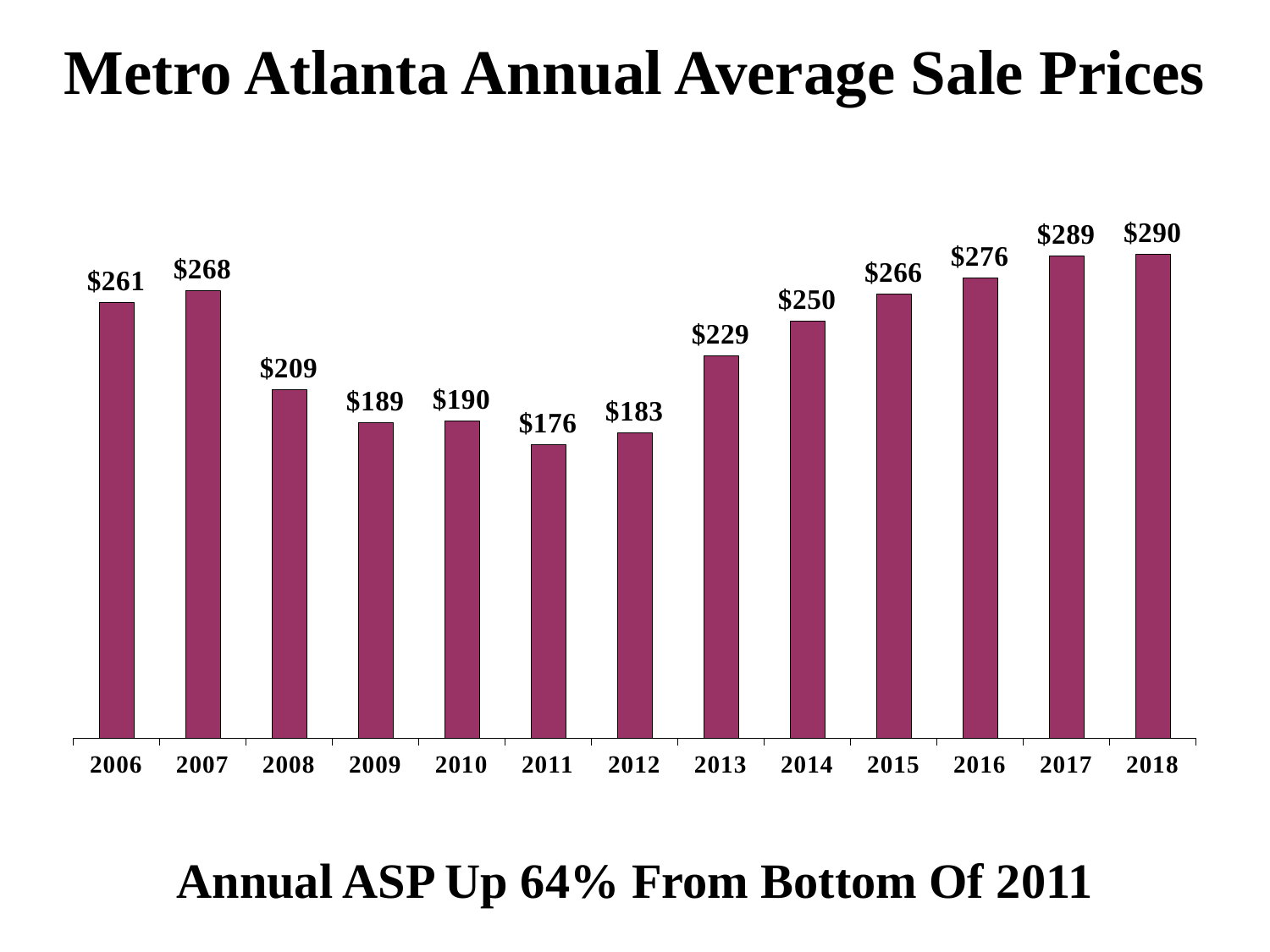
Which year has the highest average sale price? 2018 What is the difference between the 2013 value and the 2012 value? $46 What is the average sale price shown for 2014? $250 Which is larger, the value for 2006 or the value for 2015? 2015 What kind of chart is shown on the slide? Bar chart What is the average sale price shown for 2007? $268 What is the title of the chart? Metro Atlanta Annual Average Sale Prices What is the difference between the 2018 value and the 2011 value? $114 Which year has the lowest average sale price? 2011 Do the values rise or fall from 2011 to 2018? Rise How many years are shown on the x axis? 13 What is the average sale price shown for 2011? $176